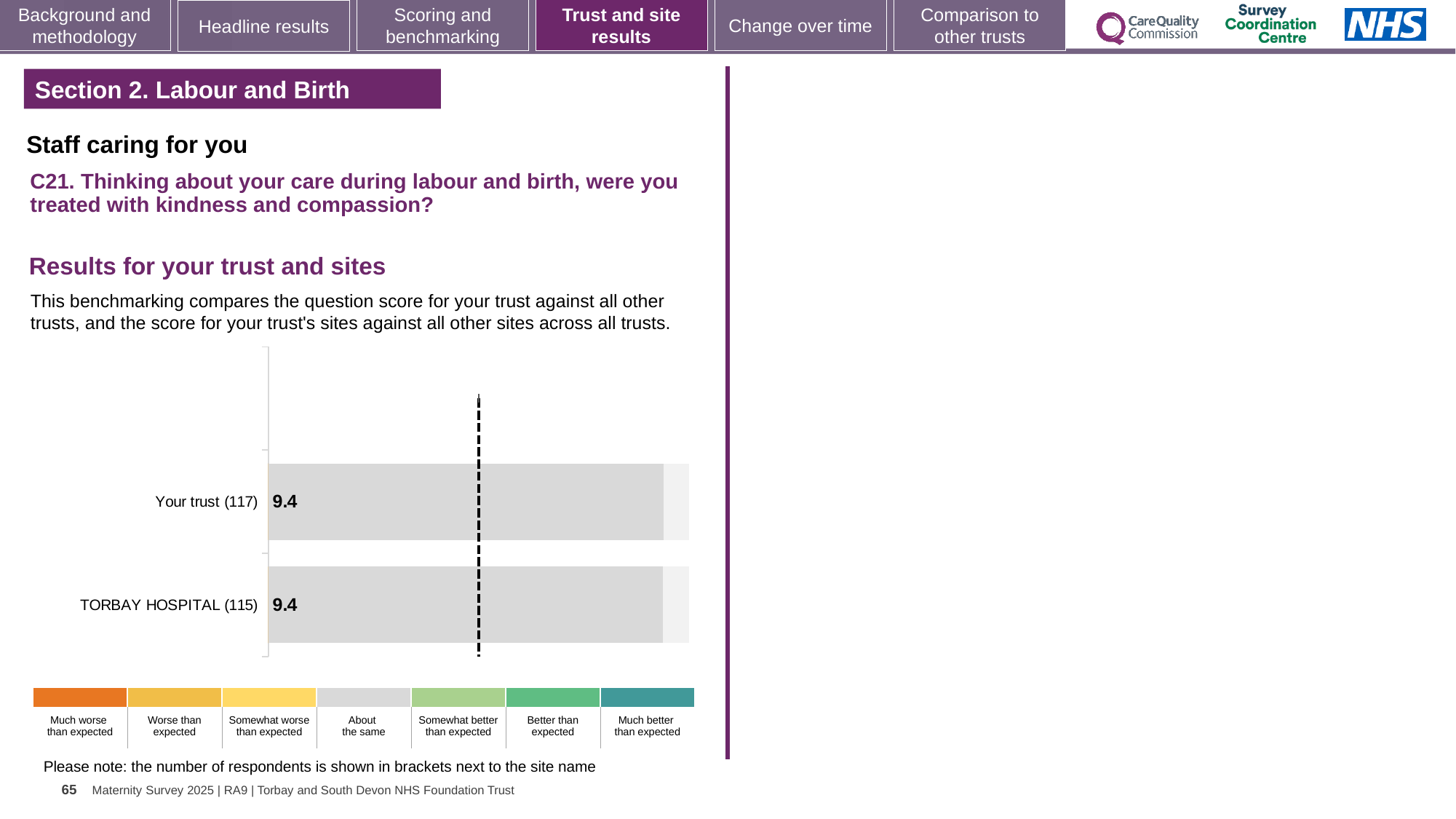
How many categories does the colour key below the chart list, from 'Much worse than expected' to 'Much better than expected'? 7 How many respondents are shown in brackets for Your trust? 117 What is the score for Your trust? 9.4 How many respondents are shown in brackets for TORBAY HOSPITAL? 115 What kind of chart is shown on the slide? bar chart How many bars are plotted in the chart? 2 What is the difference between the score for Your trust and the score for TORBAY HOSPITAL? 0 Is the score for Your trust larger than, smaller than, or equal to the score for TORBAY HOSPITAL? equal What is the score for TORBAY HOSPITAL? 9.4 Which survey question does the chart on the slide relate to? C21. Thinking about your care during labour and birth, were you treated with kindness and compassion?